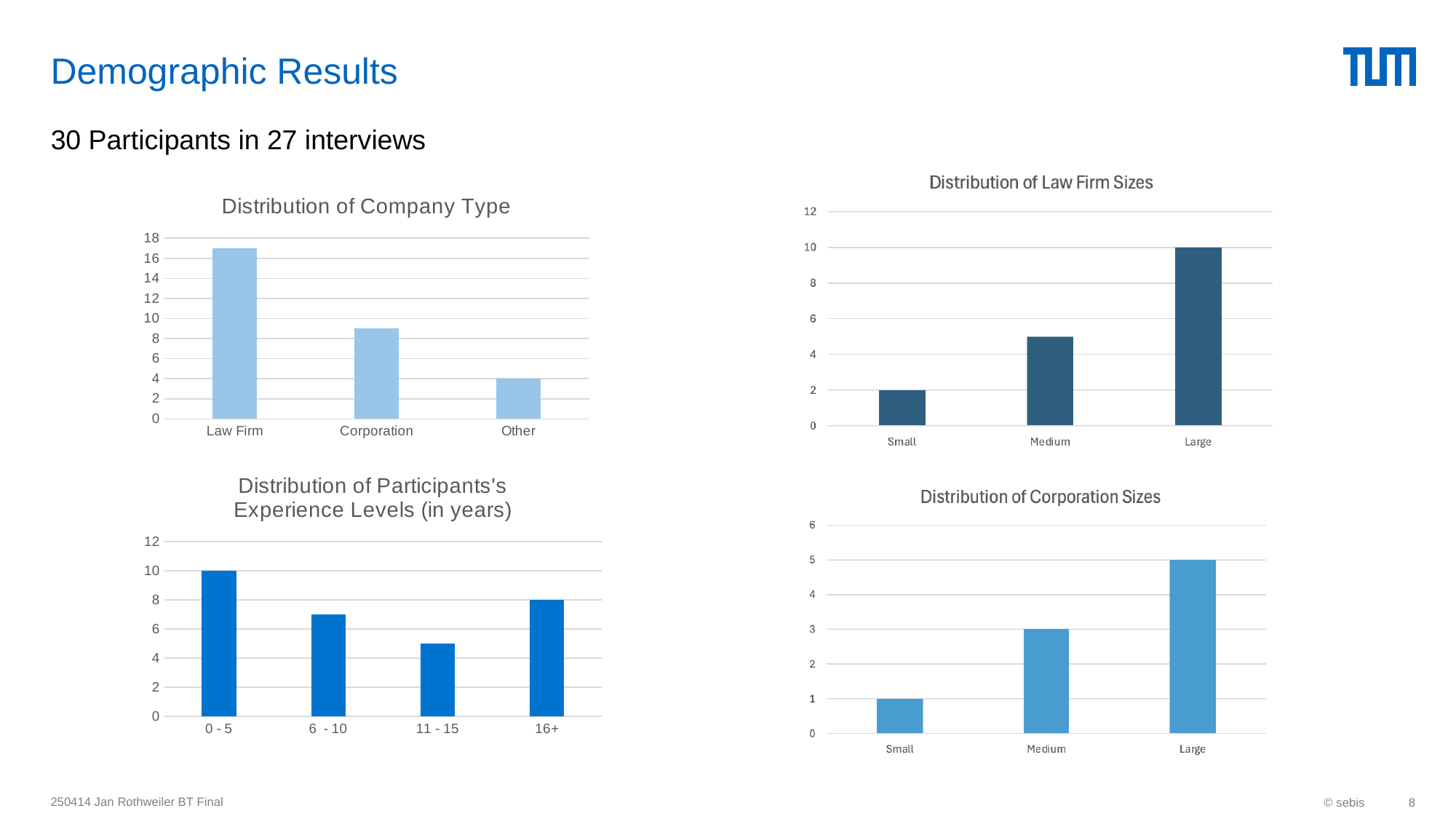
In the Distribution of Law Firm Sizes chart, what is the difference between the values for Large and Small? 8 In the Distribution of Participants's Experience Levels chart, which is larger, the value for 6 - 10 or the value for 16+? 16+ In the Distribution of Company Type chart, is the value for Corporation greater or less than 10? less In the Distribution of Law Firm Sizes chart, what is the value for Large? 10 In the Distribution of Corporation Sizes chart, what is the value for Medium? 3 In the Distribution of Law Firm Sizes chart, what is the value for Small? 2 In the Distribution of Participants's Experience Levels chart, what is the value for 0 - 5? 10 In the Distribution of Company Type chart, which category has the highest value? Law Firm In the Distribution of Company Type chart, is the value for Law Firm greater or less than 16? greater How many charts are shown on the slide? 4 In the Distribution of Company Type chart, what is the value for Other? 4 In the Distribution of Corporation Sizes chart, which category has the lowest value? Small